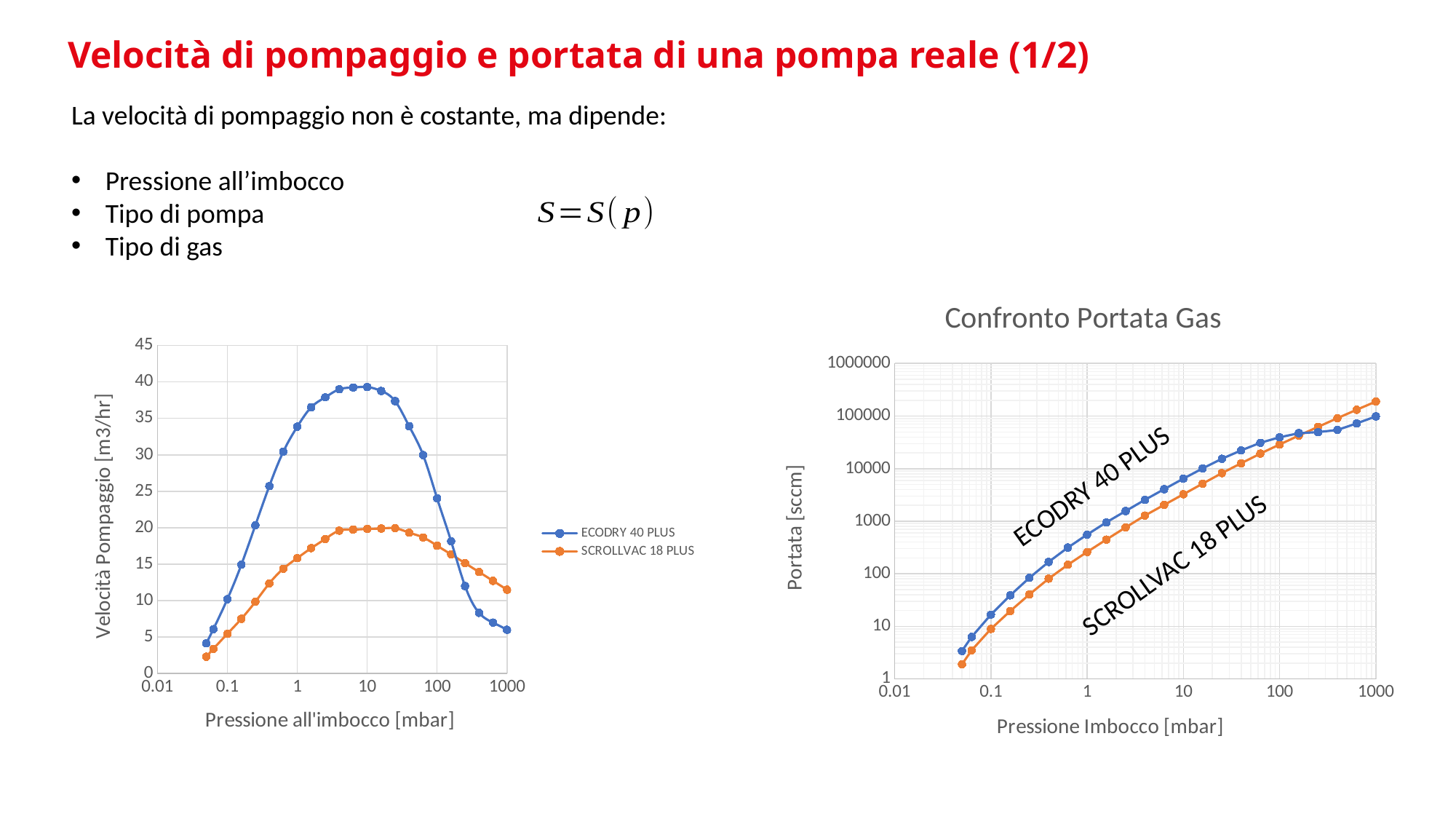
In the left chart, is the peak value for ECODRY 40 PLUS greater or less than 35? greater In the left chart, is the peak value for SCROLLVAC 18 PLUS greater or less than 25? less In the left chart, is the value for ECODRY 40 PLUS at 1000 mbar greater or less than 10? less In the left chart, which series reaches the higher peak pumping speed? ECODRY 40 PLUS What kind of chart is the left chart showing Velocità Pompaggio? line chart In the Confronto Portata Gas chart, at 1 mbar, which series has the larger flow rate, ECODRY 40 PLUS or SCROLLVAC 18 PLUS? ECODRY 40 PLUS What is the title of the right chart? Confronto Portata Gas How many series does the legend of the left chart list? 2 In the Confronto Portata Gas chart, do the values rise or fall as the inlet pressure increases? rise What is the x-axis label of the left chart? Pressione all'imbocco [mbar] In the left chart, at 10 mbar, which series has the larger pumping speed, ECODRY 40 PLUS or SCROLLVAC 18 PLUS? ECODRY 40 PLUS